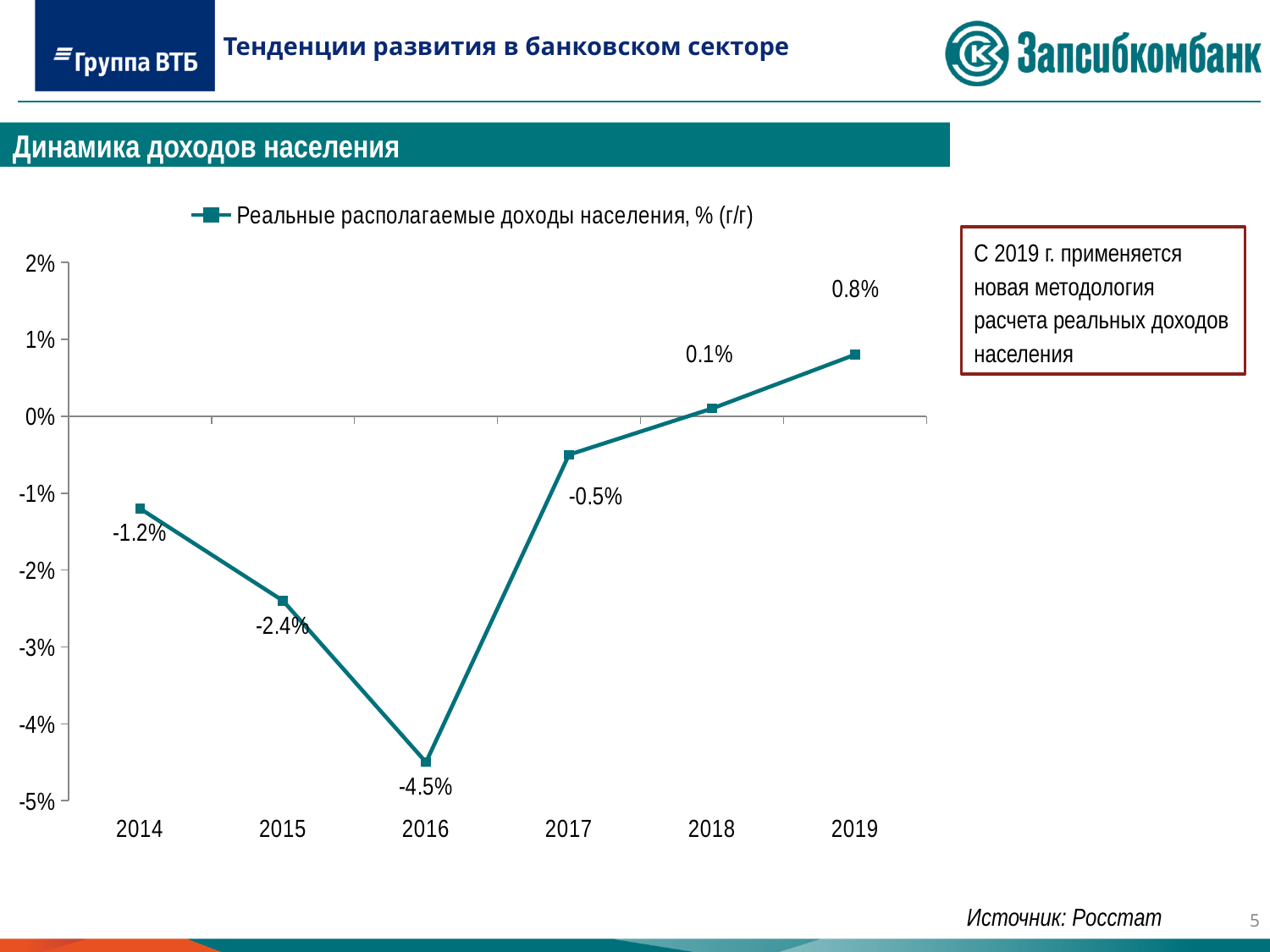
Do the values rise or fall from 2016 to 2019? rise What kind of chart is shown? line chart How many years are plotted on the chart? 6 What is the value for 2016? -4.5% What is the value for 2019? 0.8% What is the difference between the values for 2019 and 2018? 0.7% What is the value for 2018? 0.1% Which year has the highest value? 2019 What is the series name shown in the legend? Реальные располагаемые доходы населения, % (г/г) What is the value for 2014? -1.2% Which year has the lowest value? 2016 Which is larger, the value for 2015 or the value for 2017? 2017